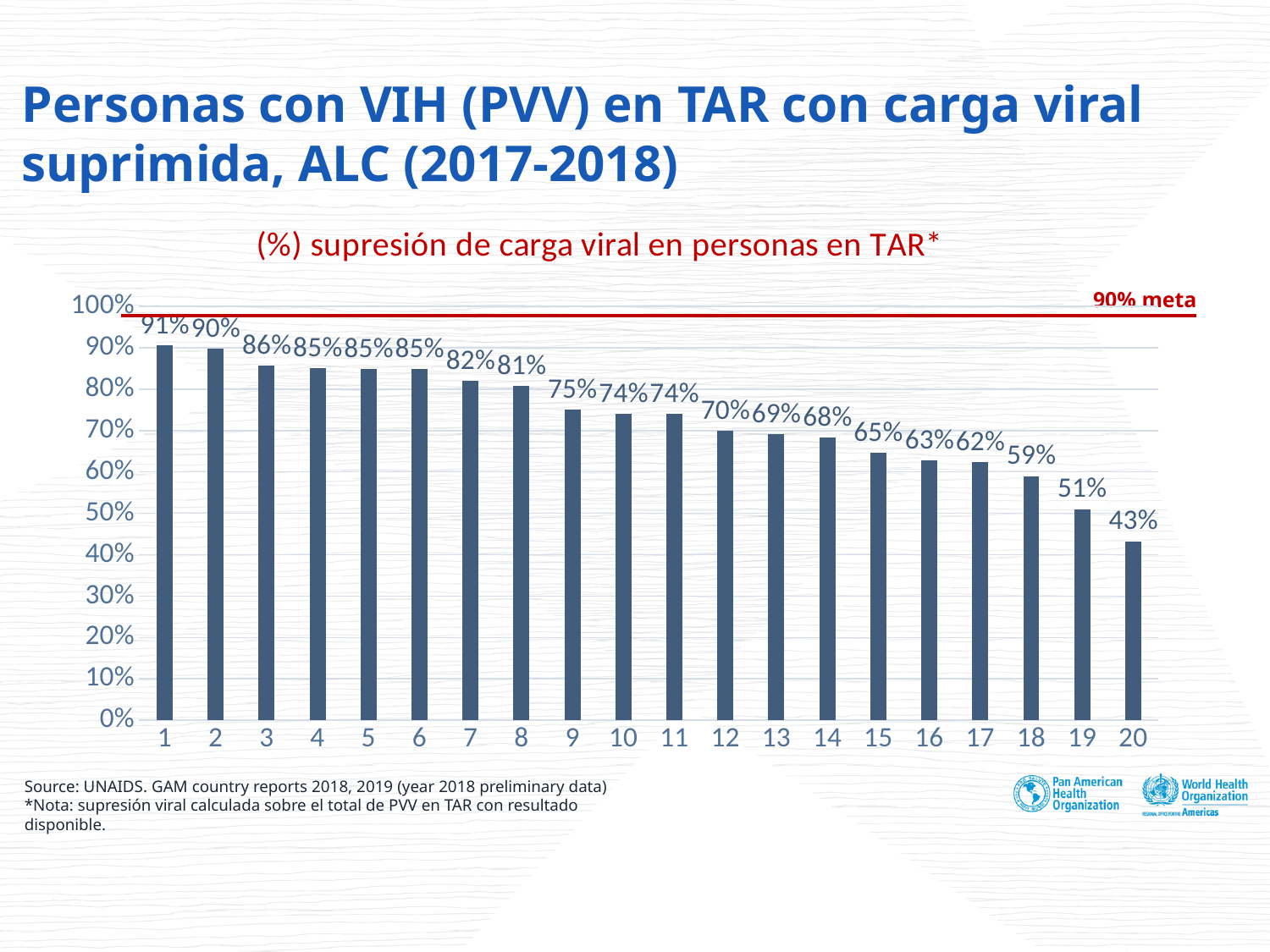
What target value does the red horizontal line represent? 90% meta Which category has the lowest value? 20 Which category has the highest value? 1 Is the value for category 15 greater or less than 70%? less What is the difference between the values for category 1 and category 20? 48% How many categories are shown on the x axis? 20 Do the values rise or fall from category 1 to category 20? fall What is the value for category 9? 75% Which is larger, the value for category 12 or the value for category 18? category 12 What is the value for category 20? 43% What is the value for category 1? 91% What kind of chart is shown on the slide? bar chart